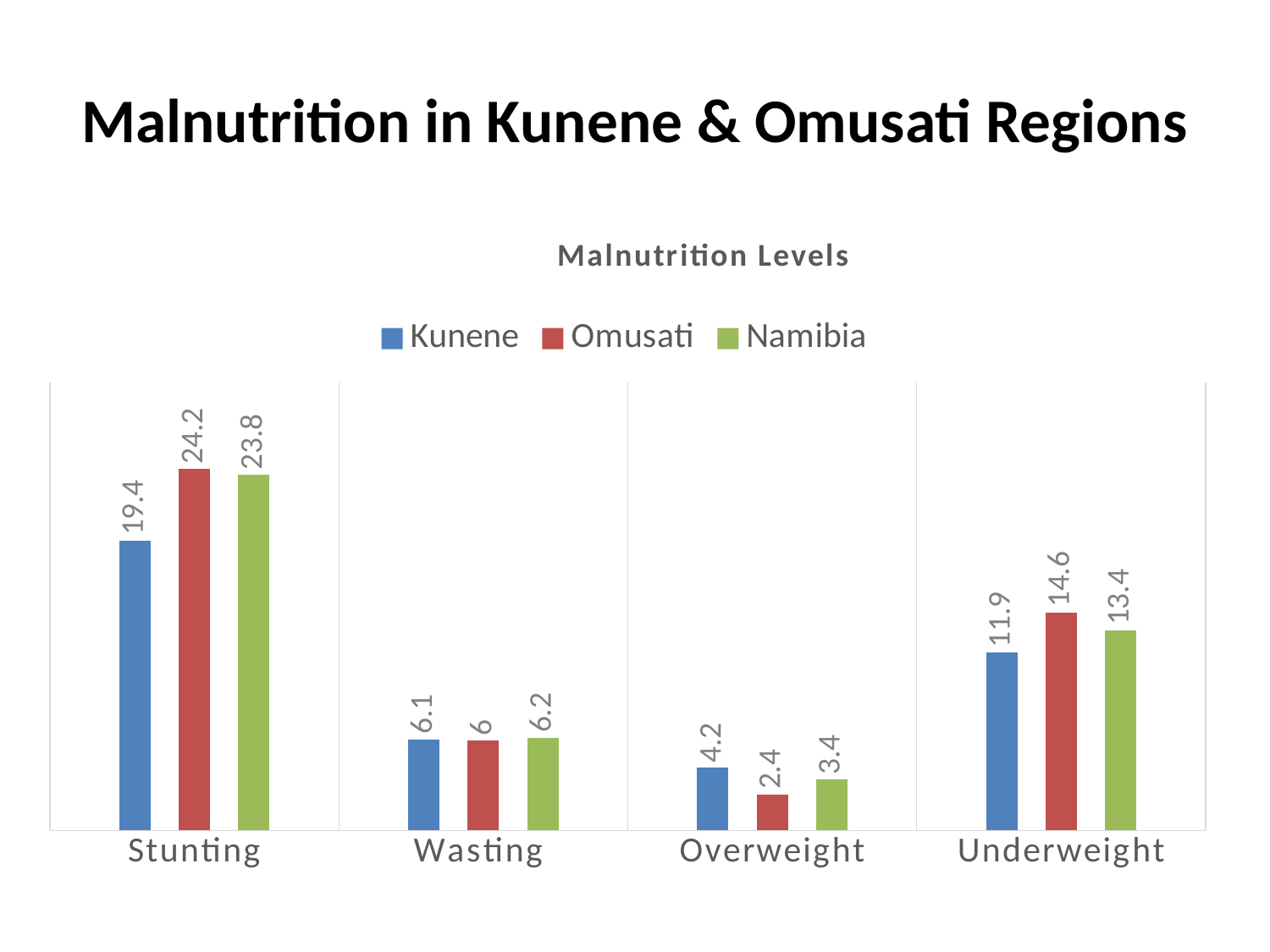
What is the title of the chart? Malnutrition Levels How many categories are shown on the x axis? 4 What is the Namibia value for Overweight? 3.4 Which category has the lowest Kunene value? Overweight Which category has the highest Omusati value? Stunting What is the Kunene value for Stunting? 19.4 What kind of chart is shown? Bar chart Which is larger for Overweight, the Kunene value or the Omusati value? Kunene What is the difference between the Omusati and Kunene values for Stunting? 4.8 What is the Omusati value for Wasting? 6 What is the Omusati value for Underweight? 14.6 How many series does the legend list? 3